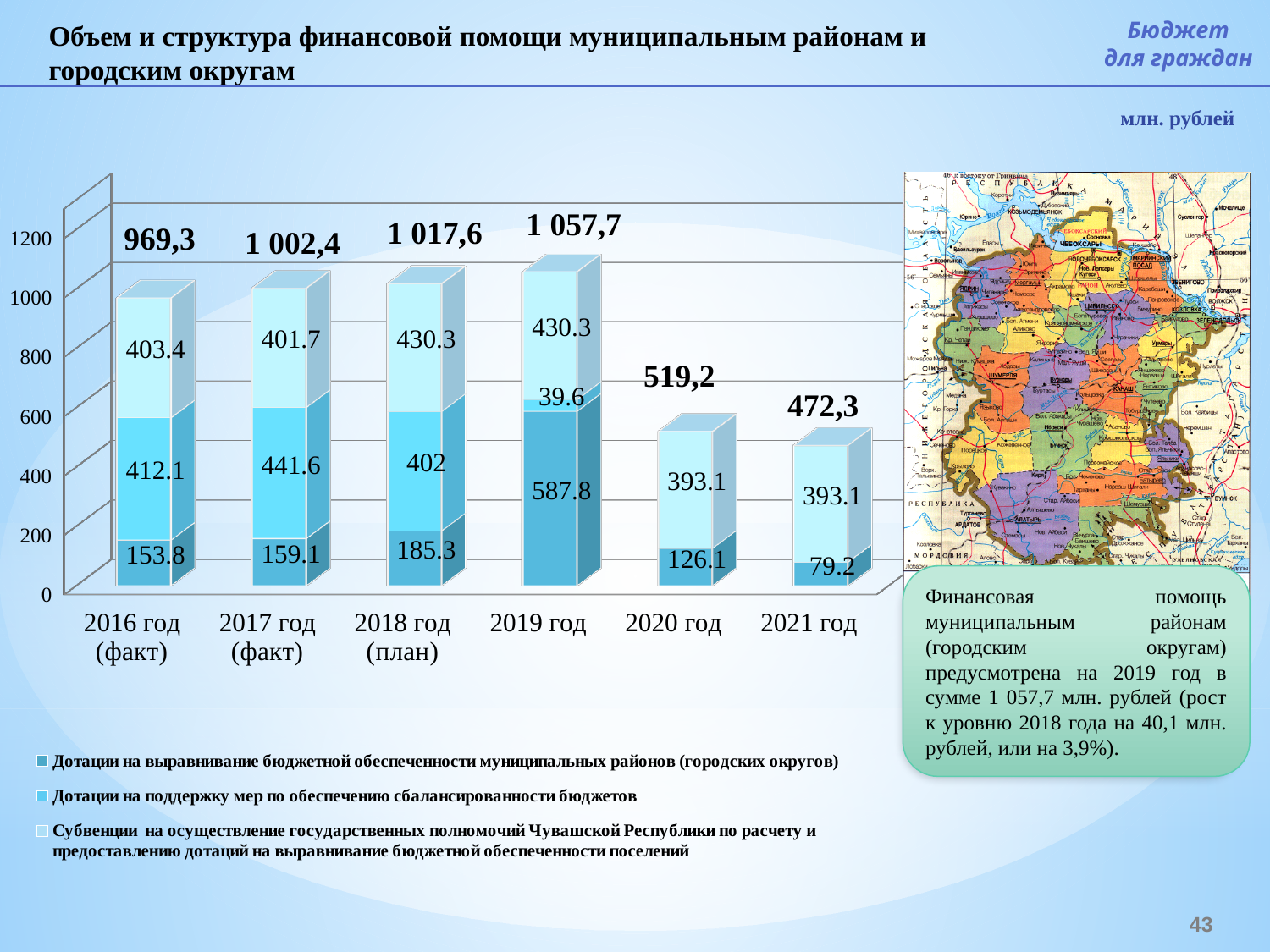
What is the total financial aid shown above the bar for 2019 год? 1 057,7 Which year has the highest total financial aid? 2019 год What is the value of the bottom segment (Дотации на выравнивание бюджетной обеспеченности муниципальных районов) for 2018 год (план)? 185.3 By how much does the total for 2019 год exceed the total for 2018 год (план)? 40,1 What is the value of the top (Субвенции) segment for 2021 год? 393.1 Do the bar totals rise or fall from 2016 год to 2019 год? Rise How many series does the legend list? 3 How many years (categories) are shown on the x axis of the chart? 6 What kind of chart is shown on the slide? Stacked bar chart What unit of measurement is indicated for the chart values? млн. рублей Which year has the lowest total financial aid? 2021 год Which total is larger: 2016 год (факт) or 2017 год (факт)? 2017 год (факт)